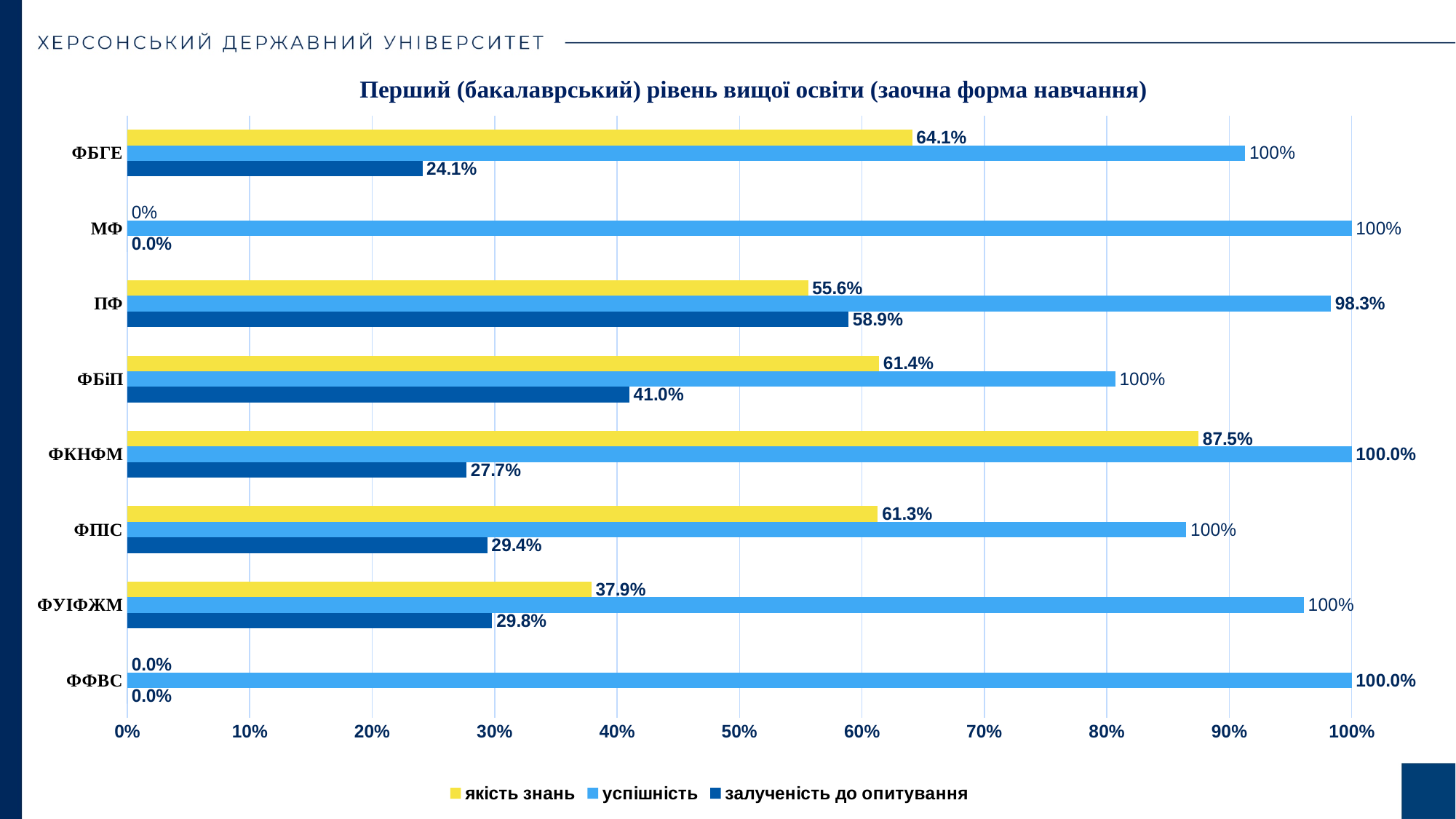
What is the difference between якість знань and залученість до опитування for ФБГЕ? 40.0 percentage points Which category has the highest value for якість знань? ФКНФМ What is the value of якість знань for ФКНФМ? 87.5% What kind of chart is shown on the slide? Bar chart What is the value of якість знань for ФУІФЖМ? 37.9% Which category has the highest value for залученість до опитування? ПФ What is the value of успішність for ПФ? 98.3% How many categories (faculties) are shown on the chart? 8 How many series does the legend list? 3 Which is larger: якість знань for ФБГЕ or якість знань for ФУІФЖМ? ФБГЕ What is the value of залученість до опитування for ПФ? 58.9%